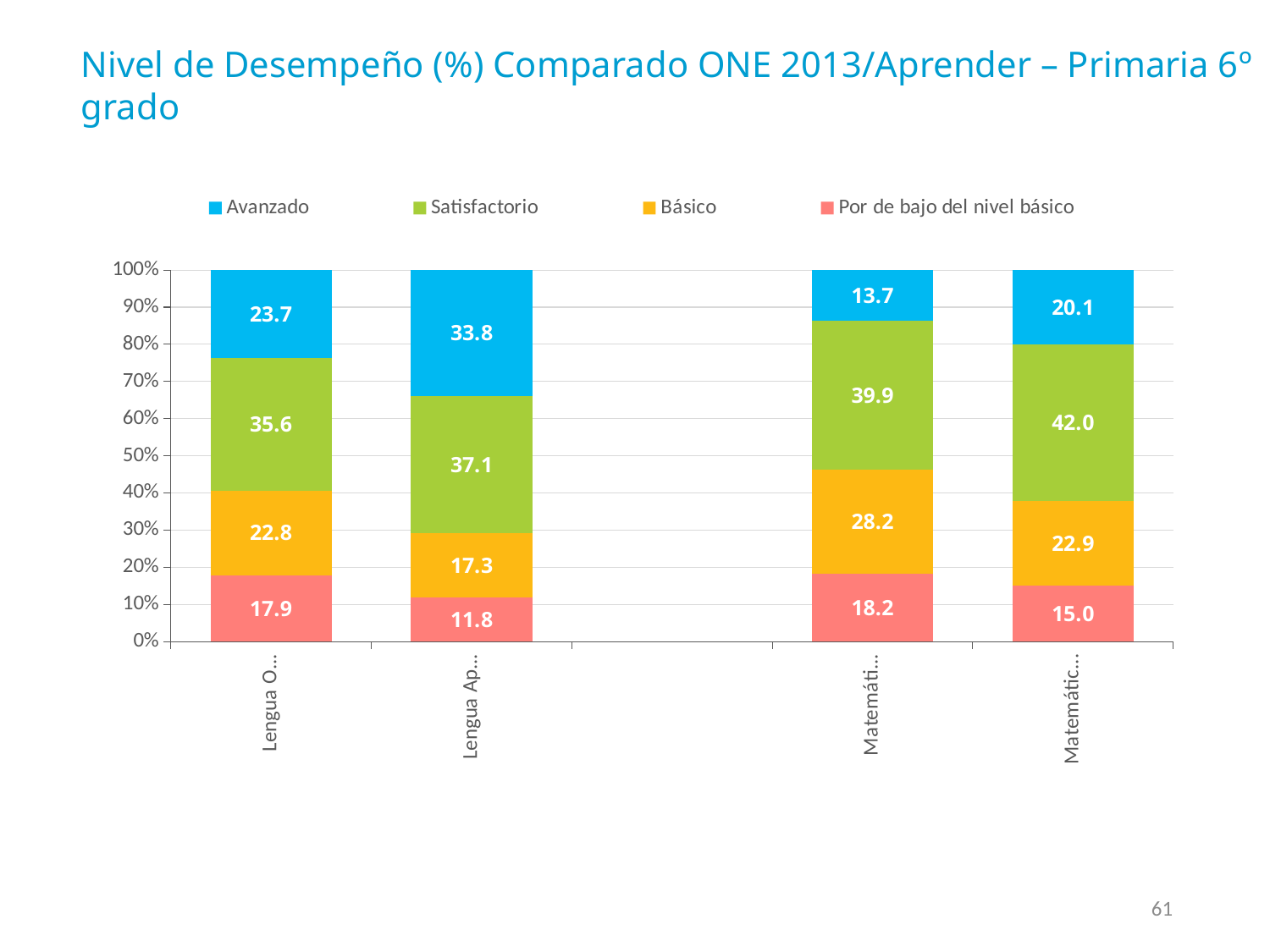
How many series does the legend list? 4 What kind of chart is shown on the slide? Stacked bar chart How many stacked bars are plotted in the chart? 4 What is the difference between the Avanzado values of the second bar and the first bar? 10.1 What is the difference between the Básico values of the third bar and the second bar? 10.9 Which has the larger Satisfactorio value, the first bar or the second bar? The second bar (37.1) What is the 'Por de bajo del nivel básico' value for the second bar from the left? 11.8 What is the Avanzado value for the first (leftmost) bar? 23.7 Which bar has the highest Avanzado value? The second bar from the left (33.8) Which bar has the lowest Avanzado value? The third bar from the left (13.7) What is the Satisfactorio value for the fourth (rightmost) bar? 42.0 What is the Básico value for the third bar from the left? 28.2